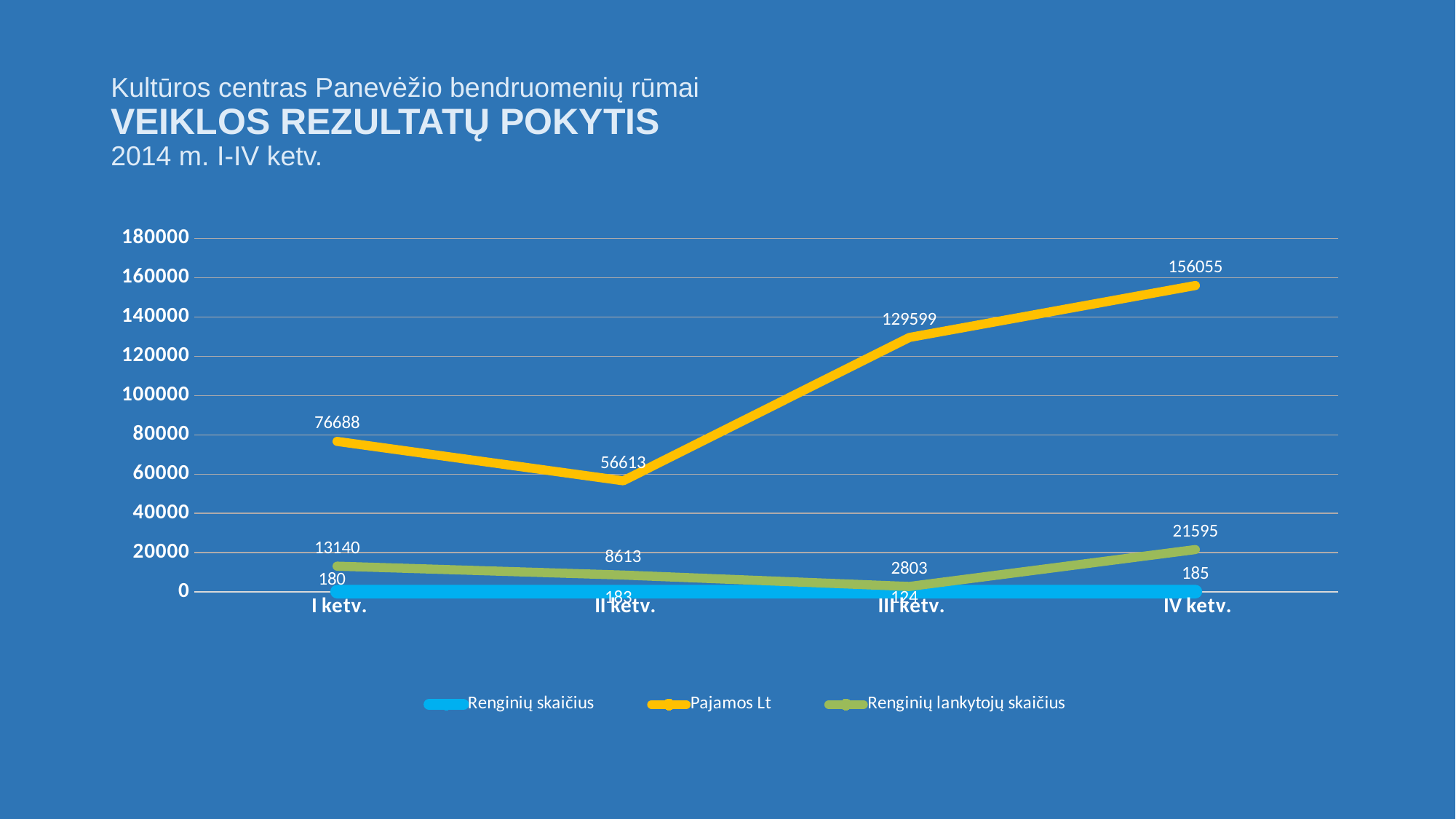
Which is larger: Pajamos Lt in I ketv. or in II ketv.? I ketv. How many series does the legend list? 3 What type of chart is shown on the slide? line chart What is the value of Renginių skaičius for III ketv.? 124 Is the value of Pajamos Lt for II ketv. greater or less than 60000? less How many quarters (categories) are plotted on the x axis? 4 What is the value of Renginių lankytojų skaičius for I ketv.? 13140 In which quarter is Pajamos Lt highest? IV ketv. Does Pajamos Lt rise or fall from II ketv. to IV ketv.? rise What is the difference between Pajamos Lt in IV ketv. and in III ketv.? 26456 In which quarter is Renginių lankytojų skaičius lowest? III ketv. What is the value of Pajamos Lt for III ketv.? 129599